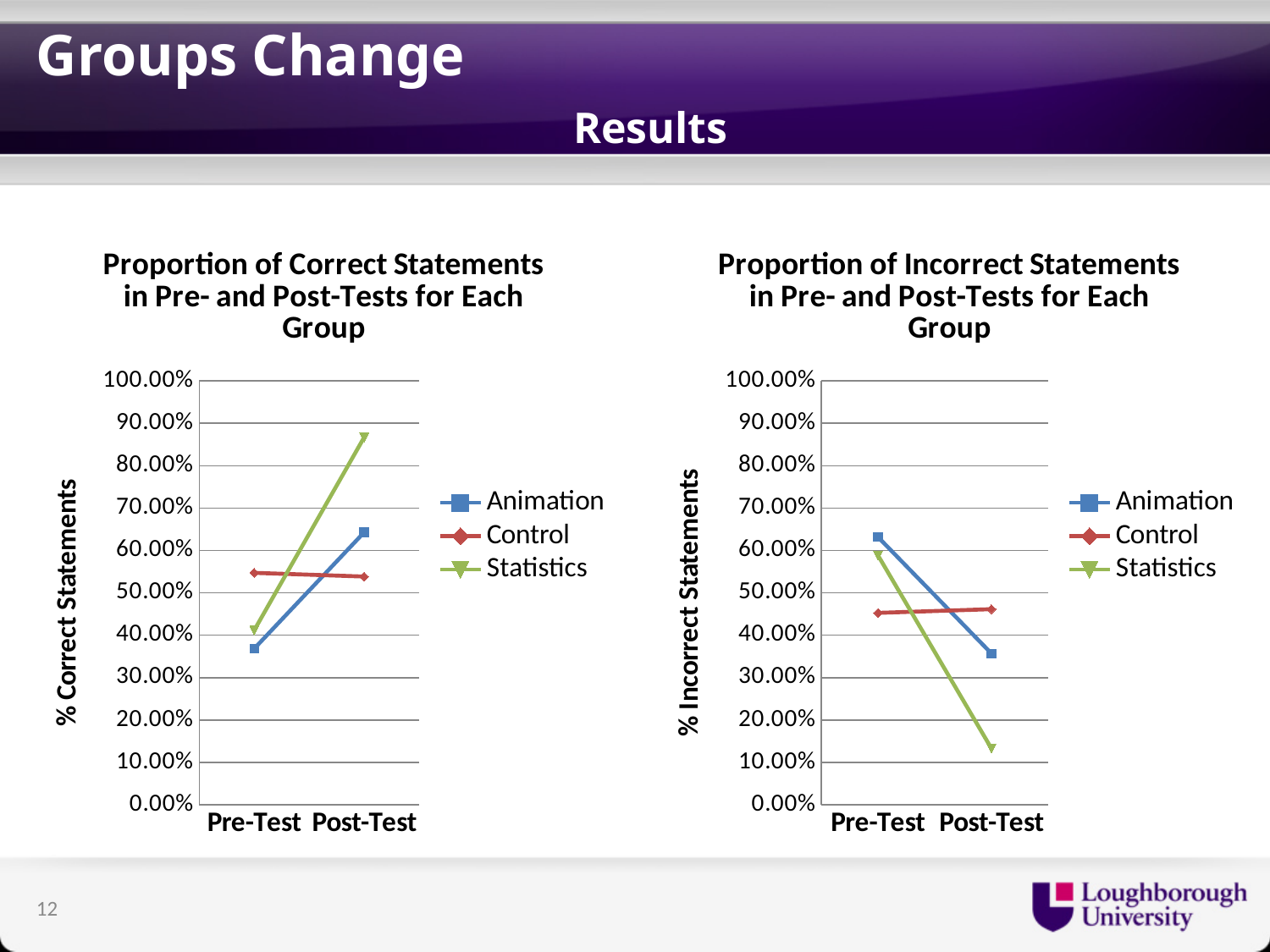
In the 'Proportion of Correct Statements in Pre- and Post-Tests for Each Group' chart, which series has the lowest value at Pre-Test? Animation In the 'Proportion of Incorrect Statements in Pre- and Post-Tests for Each Group' chart, does the Animation line rise or fall from Pre-Test to Post-Test? fall How many categories are shown on the x axis of the 'Proportion of Correct Statements in Pre- and Post-Tests for Each Group' chart? 2 What is the y-axis label of the 'Proportion of Incorrect Statements in Pre- and Post-Tests for Each Group' chart? % Incorrect Statements In the 'Proportion of Correct Statements in Pre- and Post-Tests for Each Group' chart, does the Statistics line rise or fall from Pre-Test to Post-Test? rise In the 'Proportion of Correct Statements in Pre- and Post-Tests for Each Group' chart, which series has the highest value at Post-Test? Statistics In the 'Proportion of Incorrect Statements in Pre- and Post-Tests for Each Group' chart, is the Statistics value at Post-Test greater or less than 20.00%? less What kind of chart is the 'Proportion of Correct Statements in Pre- and Post-Tests for Each Group' chart? line chart In the 'Proportion of Incorrect Statements in Pre- and Post-Tests for Each Group' chart, which is larger at Pre-Test: Animation or Control? Animation How many series does the legend of the 'Proportion of Incorrect Statements in Pre- and Post-Tests for Each Group' chart list? 3 In the 'Proportion of Correct Statements in Pre- and Post-Tests for Each Group' chart, is the Statistics value at Post-Test greater or less than 80.00%? greater In the 'Proportion of Incorrect Statements in Pre- and Post-Tests for Each Group' chart, which series has the lowest value at Post-Test? Statistics